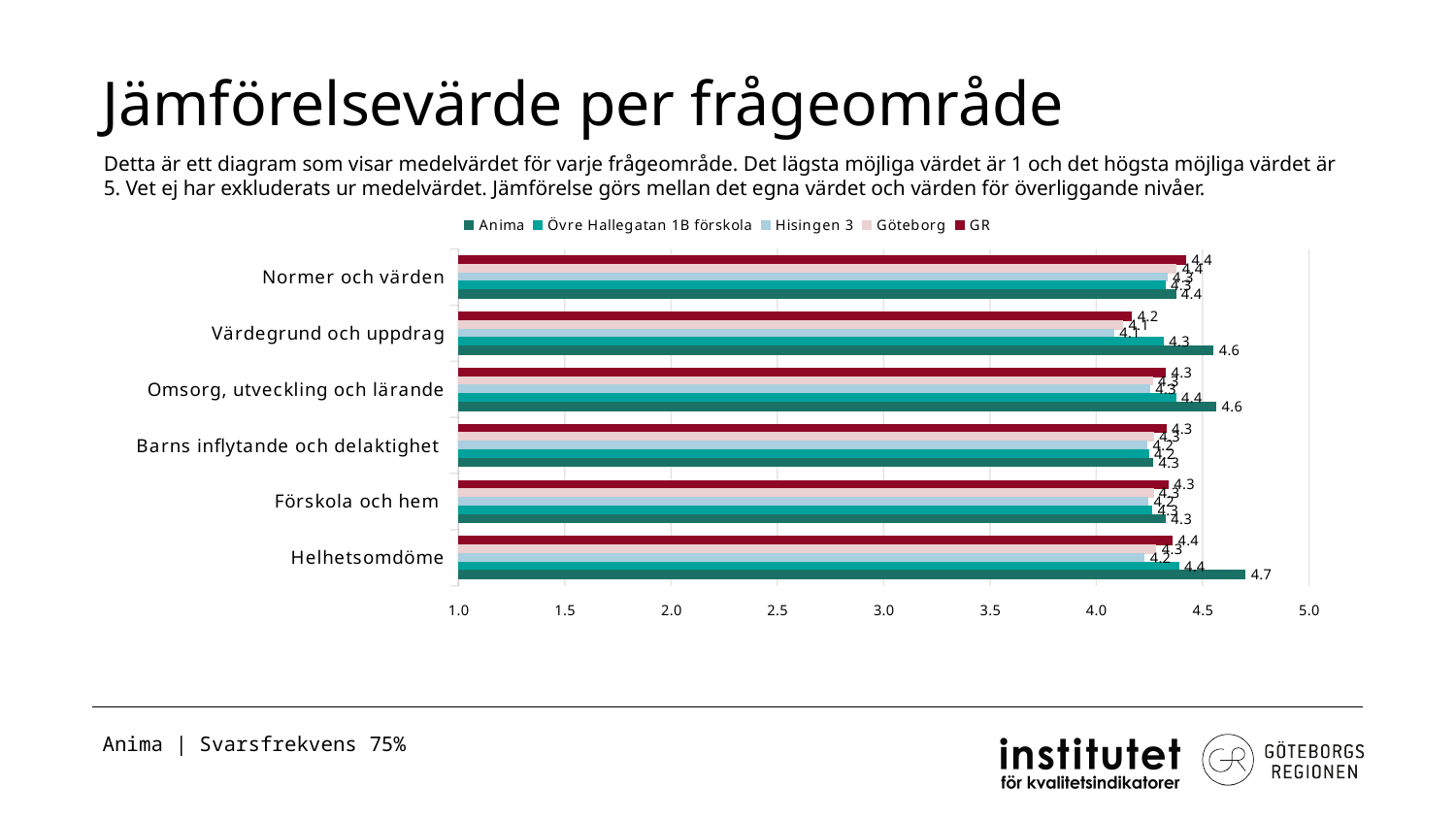
What is the value for Övre Hallegatan 1B förskola in Omsorg, utveckling och lärande? 4.4 What type of chart is shown on the slide? bar chart How many question areas (categories) are shown on the y axis? 6 Which is larger in Omsorg, utveckling och lärande: the value for Anima or the value for GR? Anima What is the value for GR in Värdegrund och uppdrag? 4.2 What is the value for Anima in Helhetsomdöme? 4.7 Is the value for Anima in Helhetsomdöme greater or less than 4.5? greater How many series does the legend list? 5 What is the title of the chart on the slide? Jämförelsevärde per frågeområde In which category does Anima have its highest value? Helhetsomdöme What is the value for Anima in Värdegrund och uppdrag? 4.6 What is the difference between the Anima value and the GR value in Helhetsomdöme? 0.3